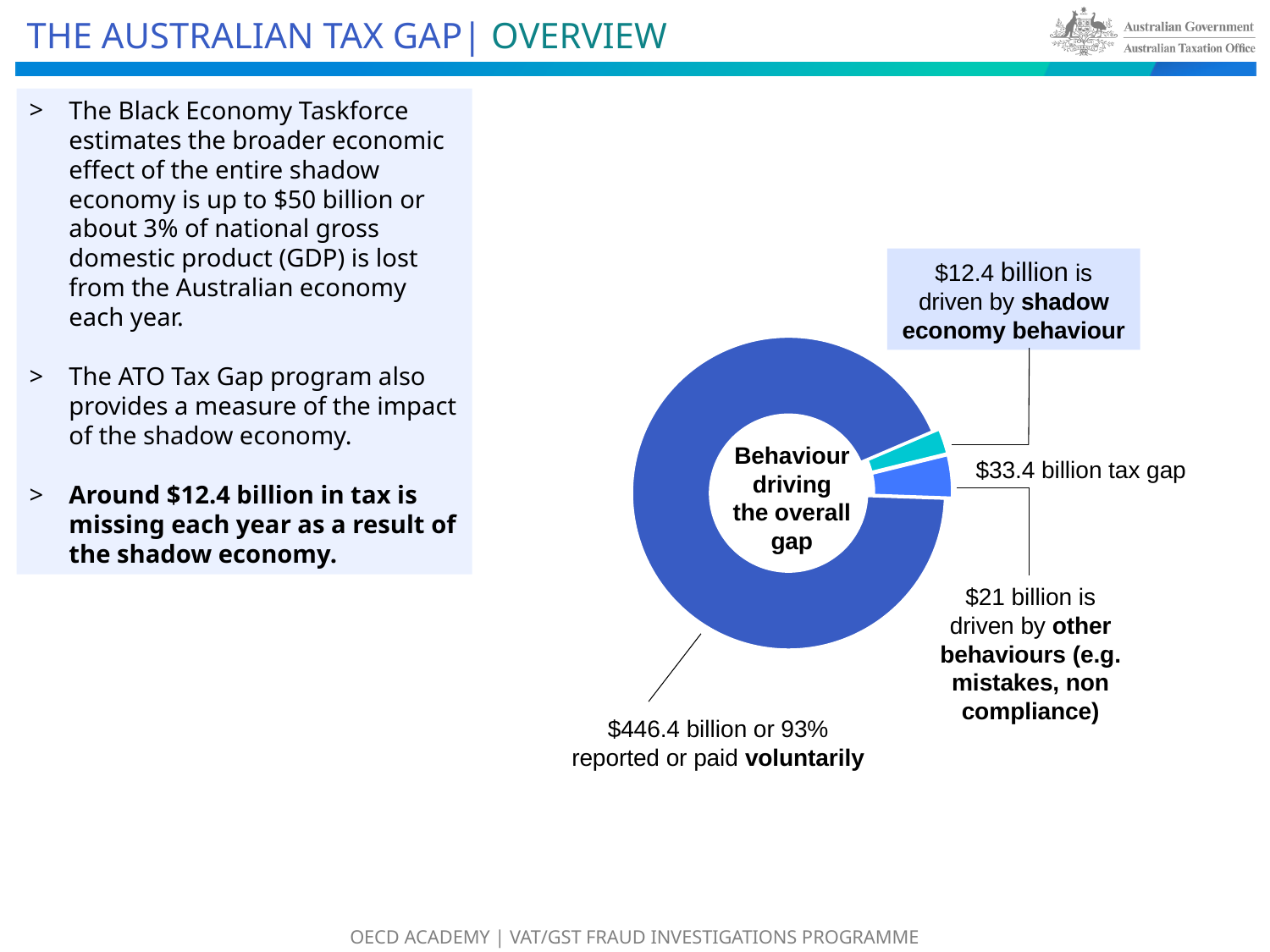
What amount is reported or paid voluntarily according to the chart? $446.4 billion What kind of chart is shown on the slide? Donut (pie) chart What is the title in the centre of the donut chart? Behaviour driving the overall gap How much of the gap is driven by other behaviours (e.g. mistakes, non compliance)? $21 billion What share of the donut chart is reported or paid voluntarily? 93% Which is larger: the amount driven by shadow economy behaviour or the amount driven by other behaviours? Other behaviours What is the total tax gap shown on the chart? $33.4 billion tax gap How much of the gap is driven by shadow economy behaviour? $12.4 billion Which slice of the donut chart is the largest? Reported or paid voluntarily How many slices does the donut chart have? 3 What is the difference between the amount driven by other behaviours and the amount driven by shadow economy behaviour? $8.6 billion Which slice of the donut chart is the smallest? Shadow economy behaviour